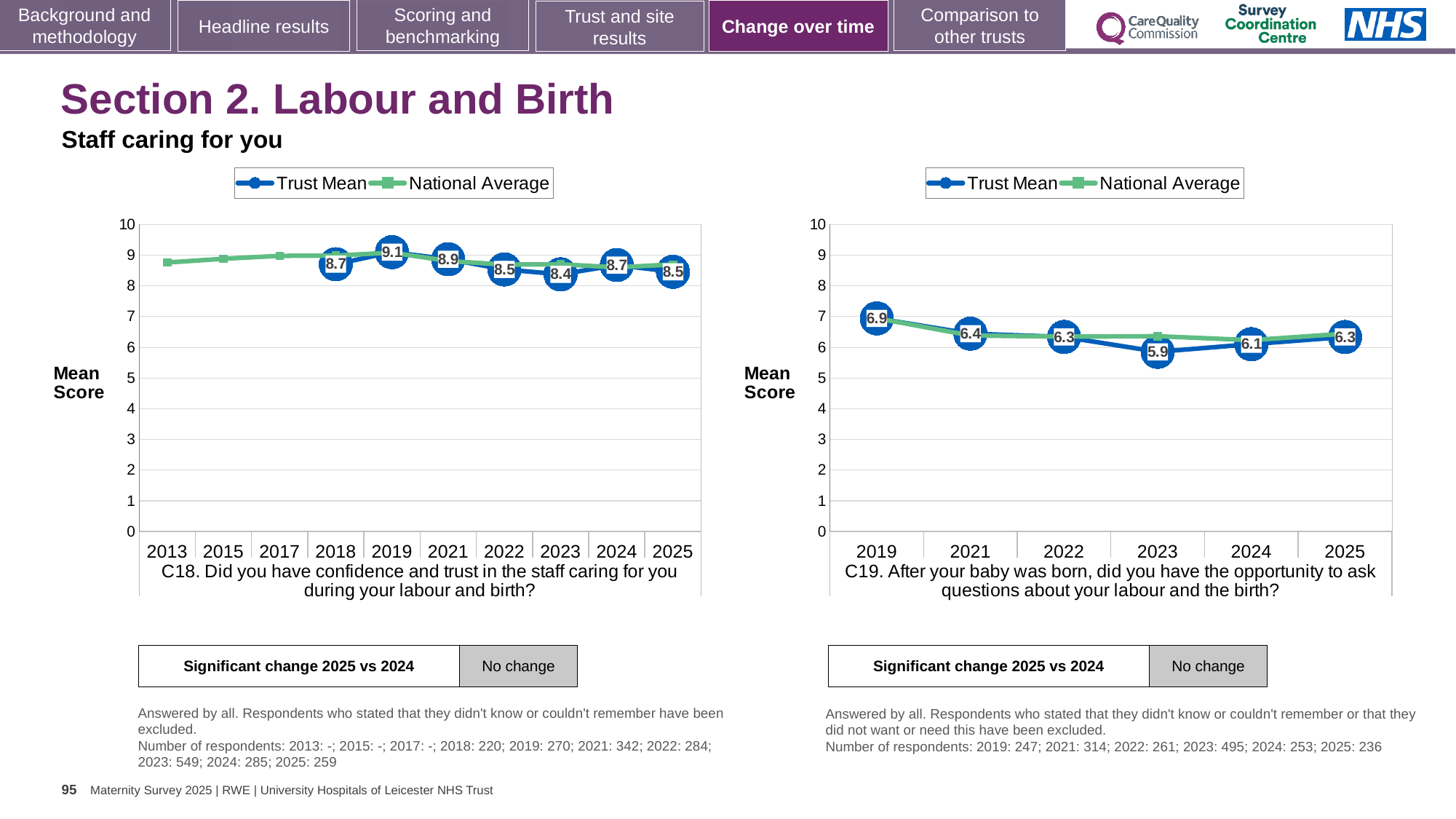
In the C19 chart (right), is the Trust Mean for 2023 greater or less than 6? less In the C18 chart (left), what is the difference between the Trust Mean in 2019 and in 2025? 0.6 In the C18 chart (left), which year has the highest Trust Mean? 2019 In the C19 chart (right), is the Trust Mean higher in 2019 or in 2025? 2019 In the C18 chart (left), how many years are shown on the x axis? 10 In the C19 chart (right), what is the Trust Mean for 2019? 6.9 How many series does the legend of the C19 chart (right) list? 2 In the C19 chart (right), what is the Trust Mean for 2023? 5.9 In the C18 chart (left), what is the Trust Mean for 2019? 9.1 In the C19 chart (right), which year has the lowest Trust Mean? 2023 In the C18 chart (left), which year has the lowest labelled Trust Mean? 2023 In the C18 chart (left), what is the Trust Mean for 2023? 8.4